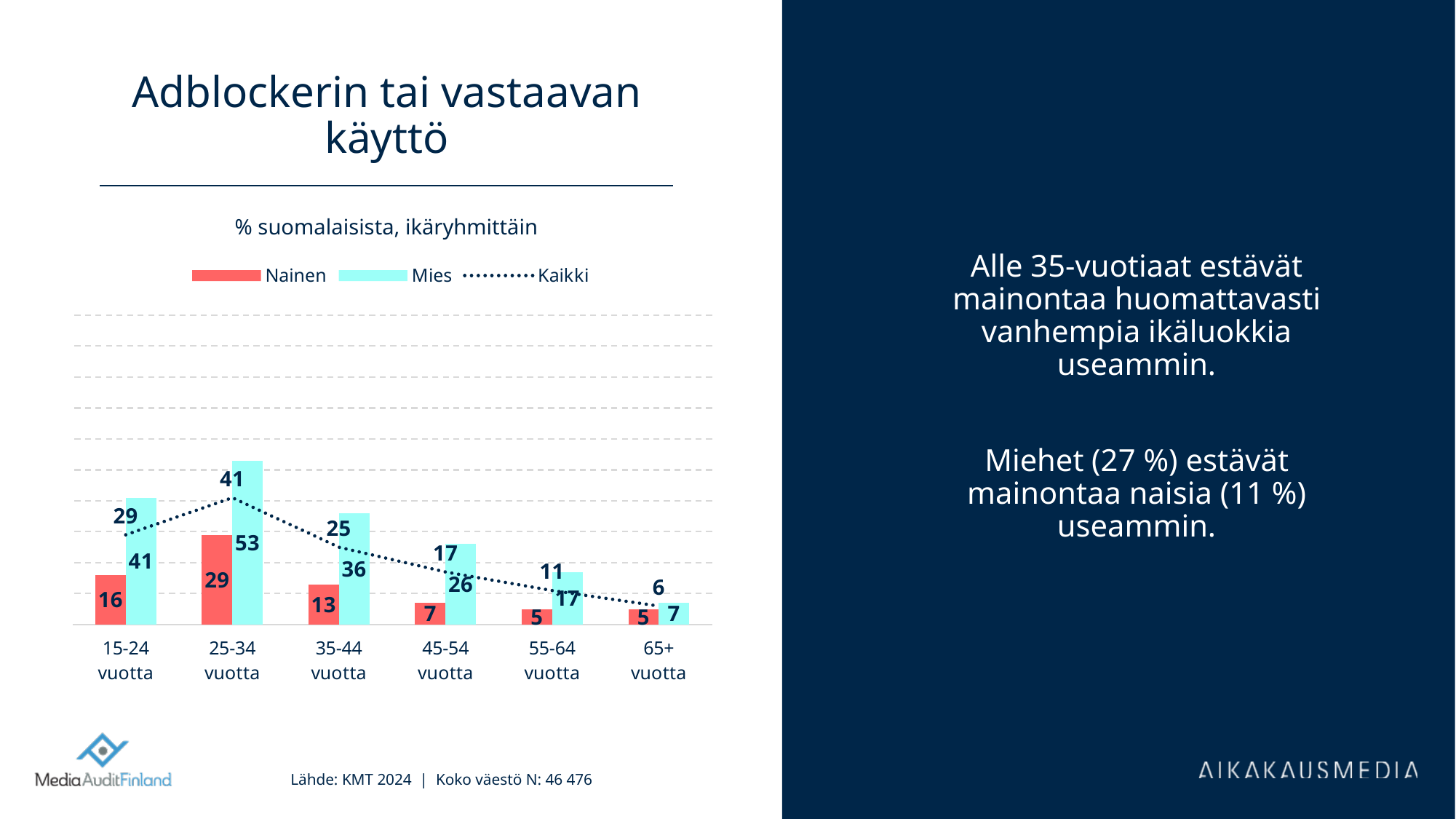
What is the Kaikki value for the 45-54 vuotta age group? 17 Which age group has the highest Mies value? 25-34 vuotta What is the value for Mies in the 25-34 vuotta age group? 53 How many series does the legend list? 3 What is the difference between the Mies and Nainen values in the 35-44 vuotta age group? 23 Which is larger in the 55-64 vuotta age group, the Nainen value or the Mies value? Mies From the 25-34 vuotta group onward, do the Kaikki values rise or fall as age increases? Fall What is the value for Nainen in the 15-24 vuotta age group? 16 Which age group has the lowest Kaikki value? 65+ vuotta Which series is shown as a dotted line in the legend? Kaikki What kind of chart is this? Bar chart with a dotted line How many age groups are shown on the x axis? 6